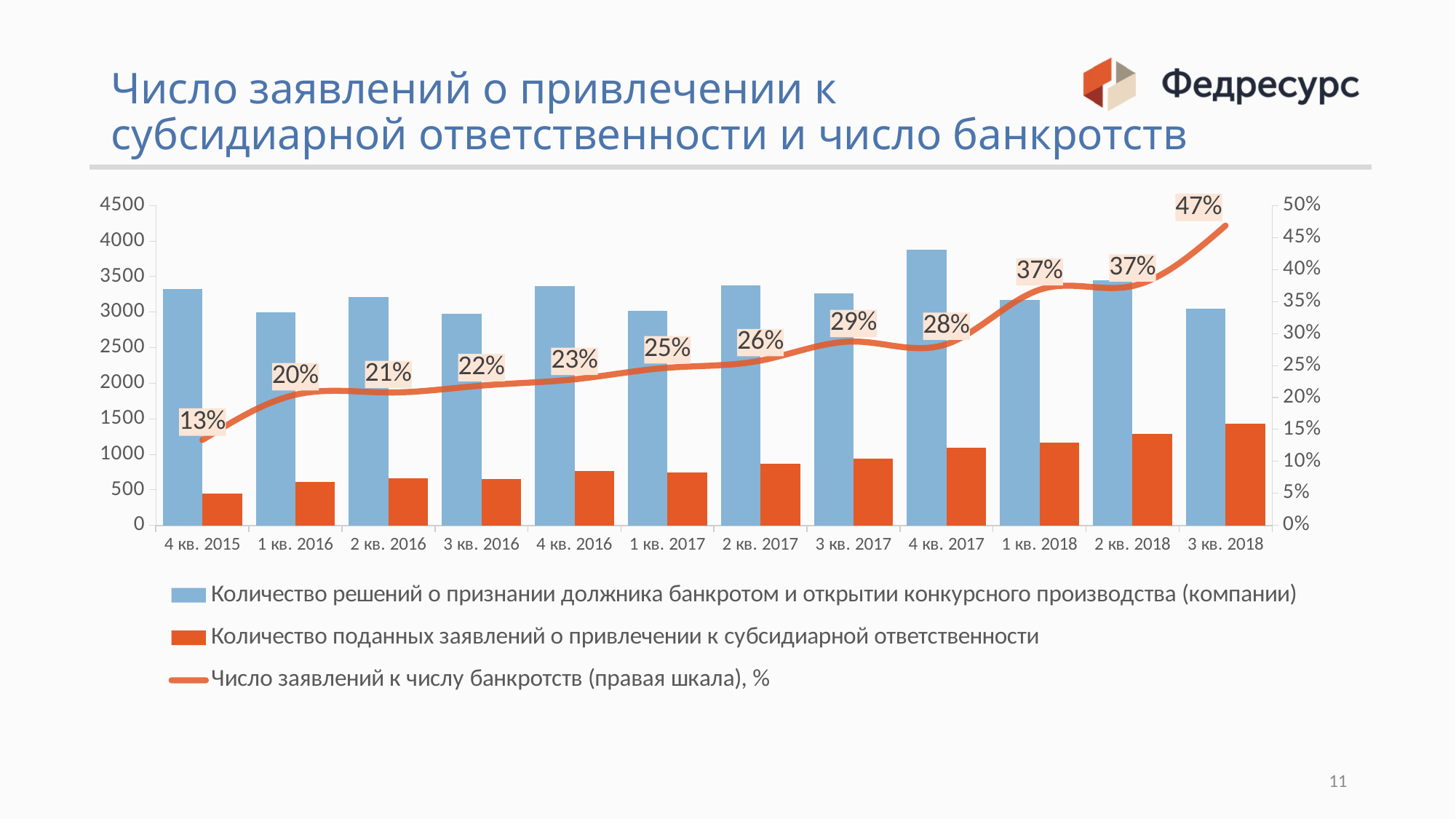
Is the value of the blue bar (bankruptcy decisions) for 4 кв. 2017 greater or less than 3500? greater How many quarters are shown on the x axis? 12 In which quarter is the orange bar (subsidiary liability applications) highest? 3 кв. 2018 What is the value of the line series (Число заявлений к числу банкротств) for 3 кв. 2018? 47% In which quarter is the ratio of applications to bankruptcies (the line series) highest? 3 кв. 2018 Which quarter has the higher line value: 3 кв. 2017 or 4 кв. 2017? 3 кв. 2017 Is the value of the orange bar (subsidiary liability applications) for 4 кв. 2015 greater or less than 500? less What is the value of the line series (Число заявлений к числу банкротств) for 4 кв. 2015? 13% By how many percentage points does the line value for 3 кв. 2018 exceed the line value for 4 кв. 2015? 34 percentage points In which quarter is the ratio of applications to bankruptcies (the line series) lowest? 4 кв. 2015 How many series does the legend list? 3 Does the line series (ratio of applications to bankruptcies) generally rise or fall from 4 кв. 2015 to 3 кв. 2018? rise